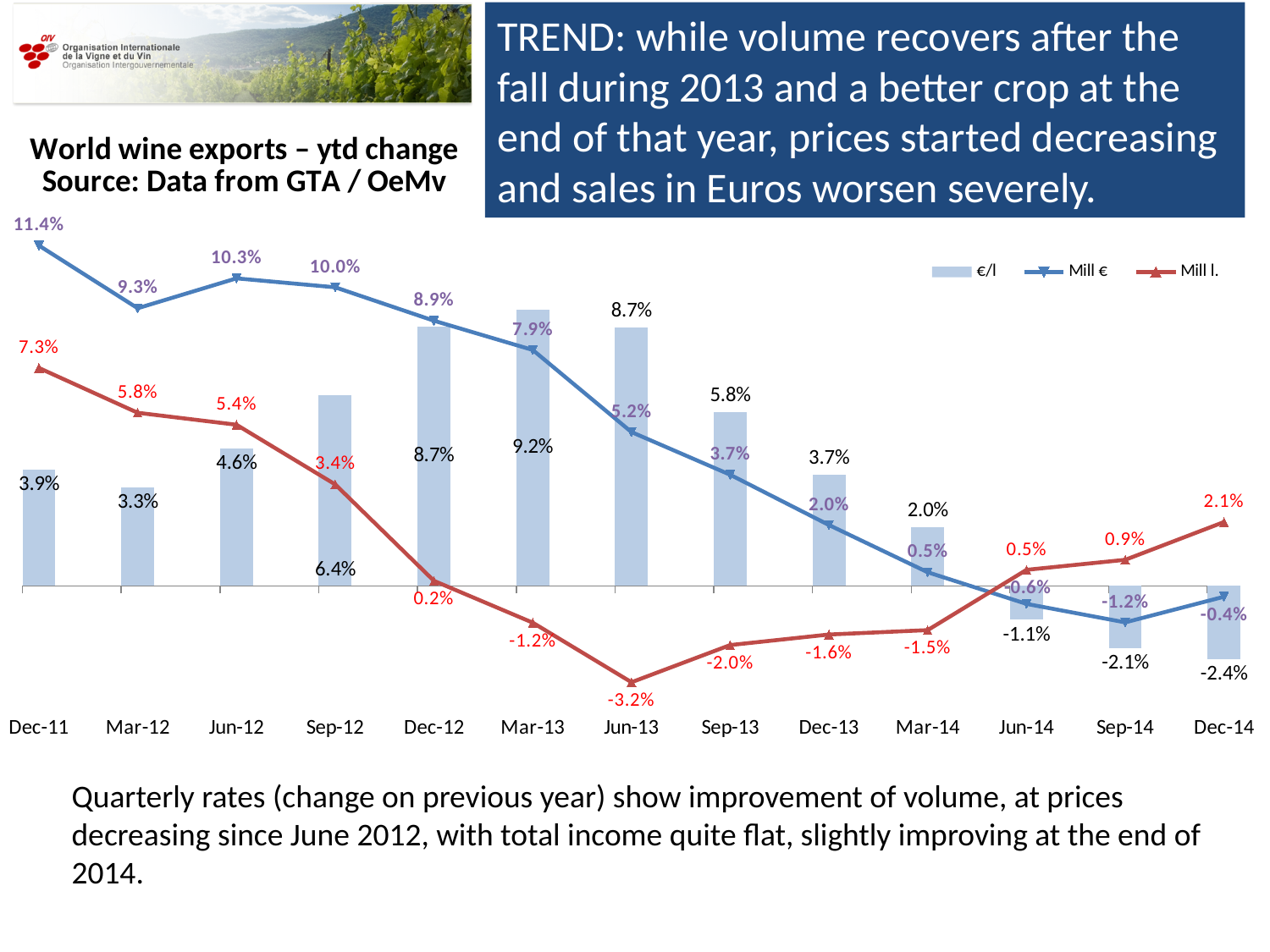
In which quarter is the Mill l. series at its lowest? Jun-13 What is the difference between the Mill € value for Dec-11 and for Dec-14? 11.8 percentage points What is the Mill € value for Dec-11? 11.4% What is the €/l value for Mar-13? 9.2% How many series does the chart legend list? 3 At Dec-14, which is larger: the Mill € value or the Mill l. value? Mill l. In which quarter is the €/l bar highest? Mar-13 What kind of chart is shown on the slide? A combination bar and line chart What is the title of the chart? World wine exports – ytd change What is the Mill l. value for Jun-13? -3.2% How many quarters are shown along the x axis of the chart? 13 Does the Mill € series rise or fall from Dec-11 to Sep-14? Fall